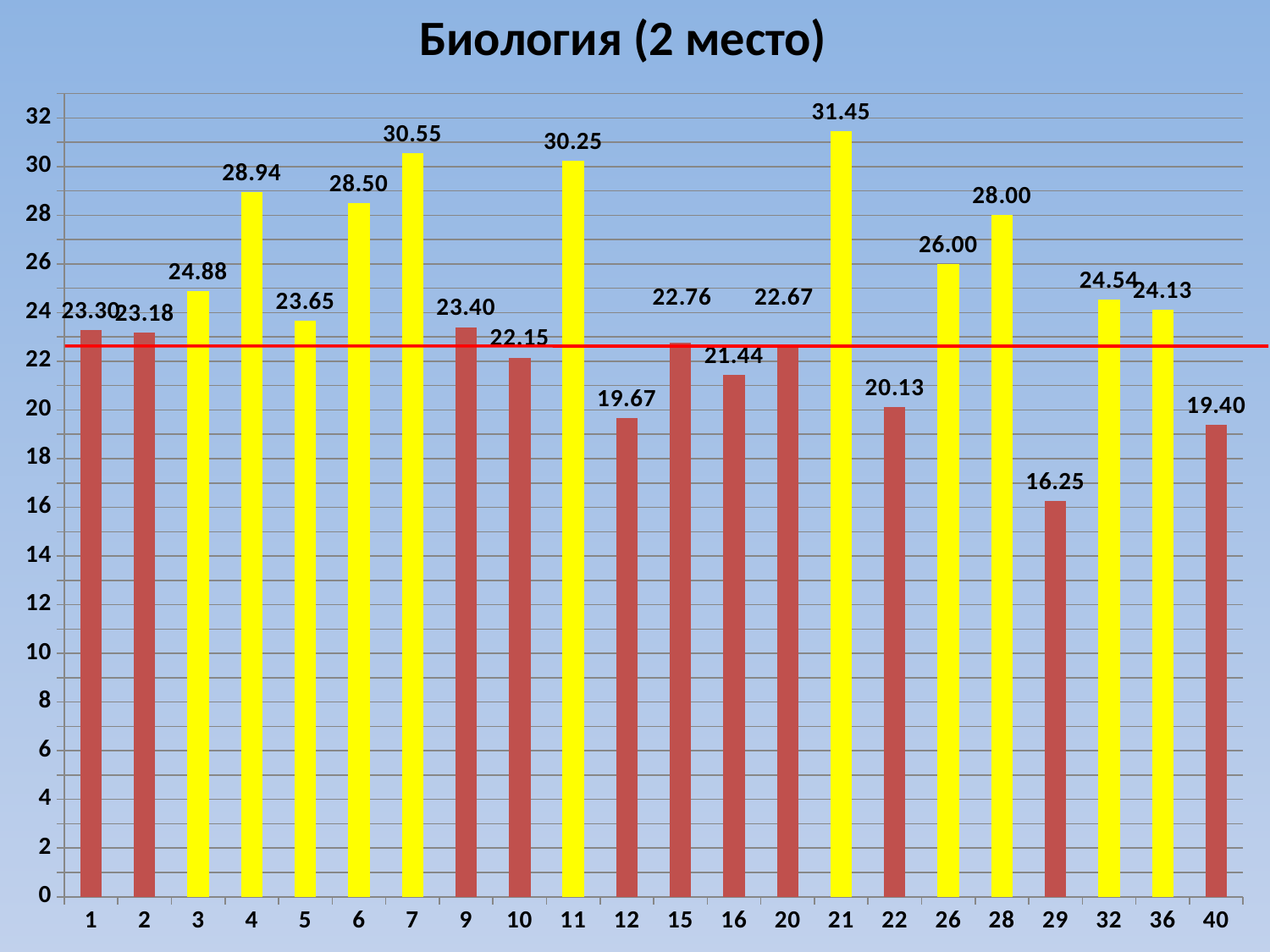
Which category has the lowest value? 29 What is the difference between the values for category 21 and category 29? 15.20 Which category has the highest value? 21 What is the value for category 7? 30.55 What is the title of the chart? Биология (2 место) How many categories are shown on the x axis? 22 What kind of chart is shown on the slide? Bar chart Which is larger, the value for category 4 or the value for category 6? Category 4 What is the value for category 29? 16.25 Is the value for category 26 greater or less than 24? greater What is the value for category 21? 31.45 What is the value for category 12? 19.67